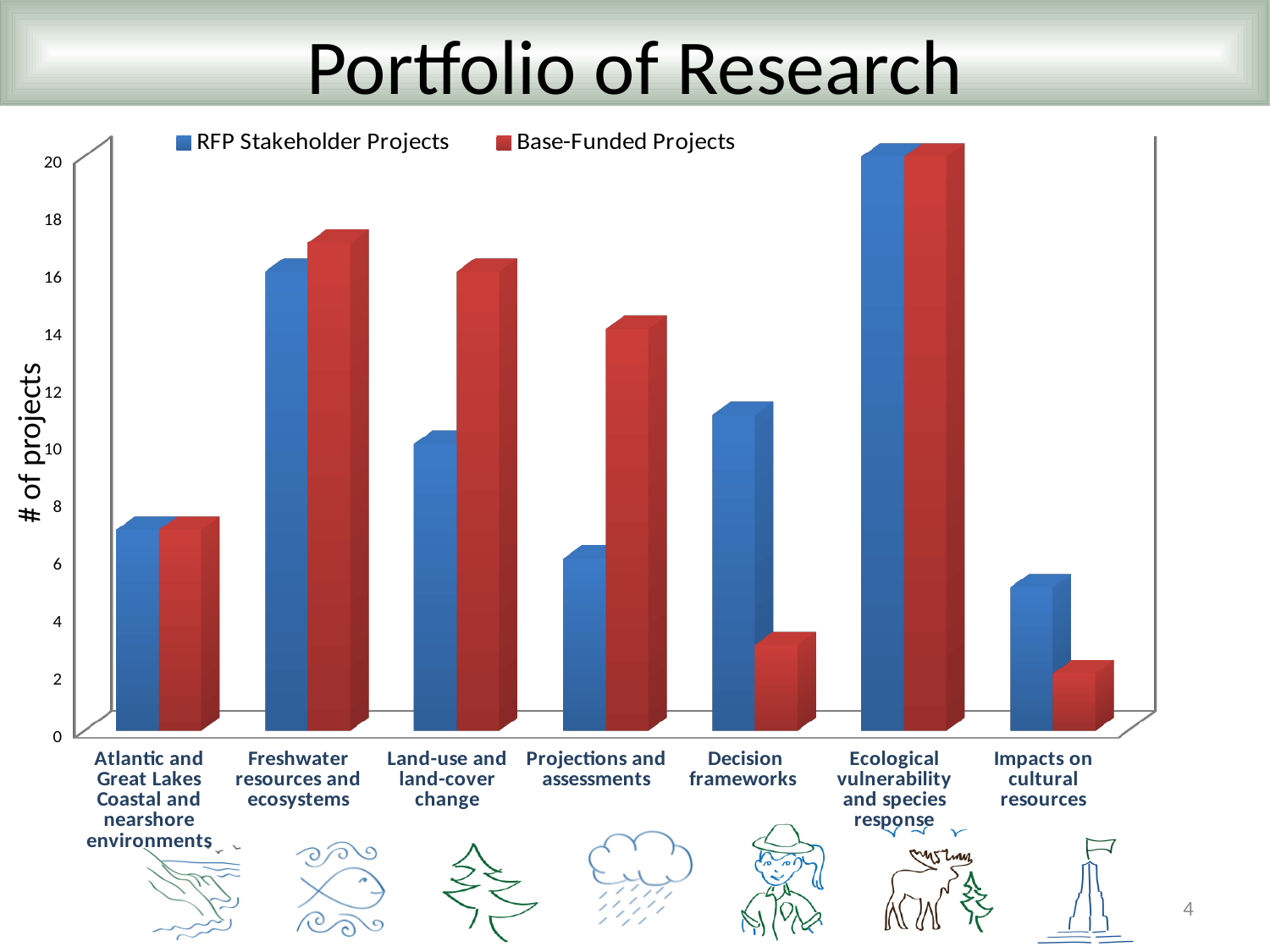
Which category has the highest number of Base-Funded Projects? Ecological vulnerability and species response Is the number of RFP Stakeholder Projects for Land-use and land-cover change greater or less than 12? less What colour represents Base-Funded Projects in the chart? red How many series does the legend list? 2 How many research categories are shown along the x axis? 7 For Decision frameworks, which series has more projects, RFP Stakeholder Projects or Base-Funded Projects? RFP Stakeholder Projects What kind of chart is shown on the slide? bar chart For Projections and assessments, which series has more projects, RFP Stakeholder Projects or Base-Funded Projects? Base-Funded Projects Is the number of Base-Funded Projects for Impacts on cultural resources greater or less than 4? less What is the title of the chart's vertical axis? # of projects Which category has the highest number of RFP Stakeholder Projects? Ecological vulnerability and species response Is the number of Base-Funded Projects for Freshwater resources and ecosystems greater or less than 14? greater